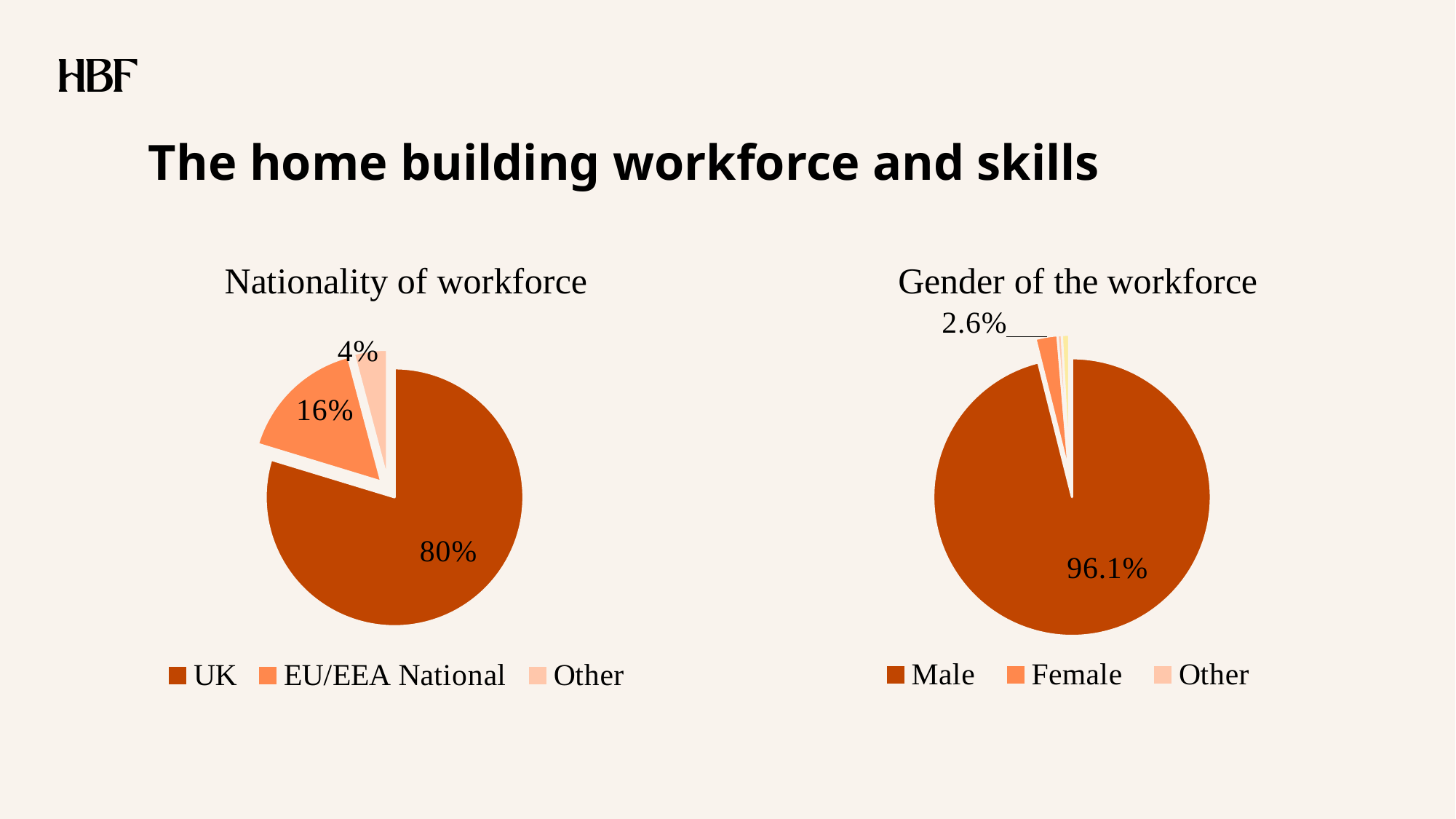
In the 'Nationality of workforce' chart, what share of the workforce is EU/EEA National? 16% In the 'Gender of the workforce' chart, what share of the workforce is Male? 96.1% How many categories does the legend of the 'Nationality of workforce' chart list? 3 In the 'Nationality of workforce' chart, which category has the largest slice? UK In the 'Gender of the workforce' chart, which is larger, the Male share or the Female share? Male In the 'Gender of the workforce' chart, what share of the workforce is Female? 2.6% In the 'Nationality of workforce' chart, what is the difference in percentage points between the UK and EU/EEA National shares? 64 What kind of chart is the 'Gender of the workforce' chart? Pie chart In the 'Nationality of workforce' chart, what share of the workforce is Other? 4% In the 'Nationality of workforce' chart, which category has the smallest slice? Other In the 'Gender of the workforce' chart, which category has the largest slice? Male In the 'Nationality of workforce' chart, what share of the workforce is UK? 80%